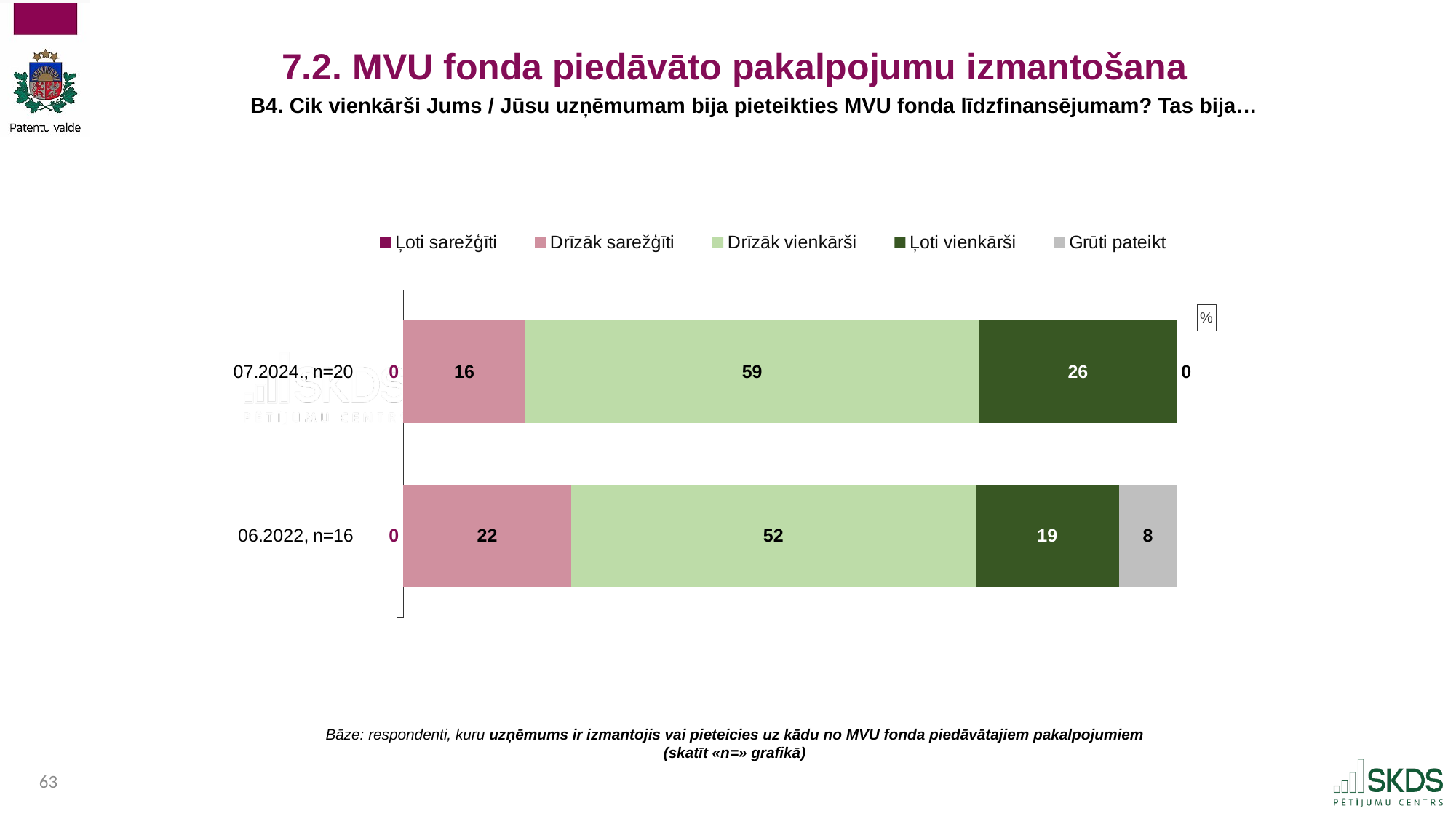
What is the value for "Ļoti sarežģīti" in the 07.2024., n=20 bar? 0 What is the difference between the "Drīzāk vienkārši" values for 07.2024., n=20 and 06.2022, n=16? 7 How many series does the legend list? 5 What is the value for "Drīzāk vienkārši" in the 07.2024., n=20 bar? 59 How many bars (survey waves) are plotted in the chart? 2 Which category has the highest value in the 06.2022, n=16 bar? Drīzāk vienkārši What kind of chart is shown on the slide? stacked bar chart What is the value for "Ļoti vienkārši" in the 07.2024., n=20 bar? 26 Which legend entry is shown in the darkest green colour? Ļoti vienkārši Which is larger: "Ļoti vienkārši" in 07.2024., n=20 or "Ļoti vienkārši" in 06.2022, n=16? 07.2024., n=20 What is the value for "Grūti pateikt" in the 06.2022, n=16 bar? 8 What is the value for "Drīzāk sarežģīti" in the 06.2022, n=16 bar? 22